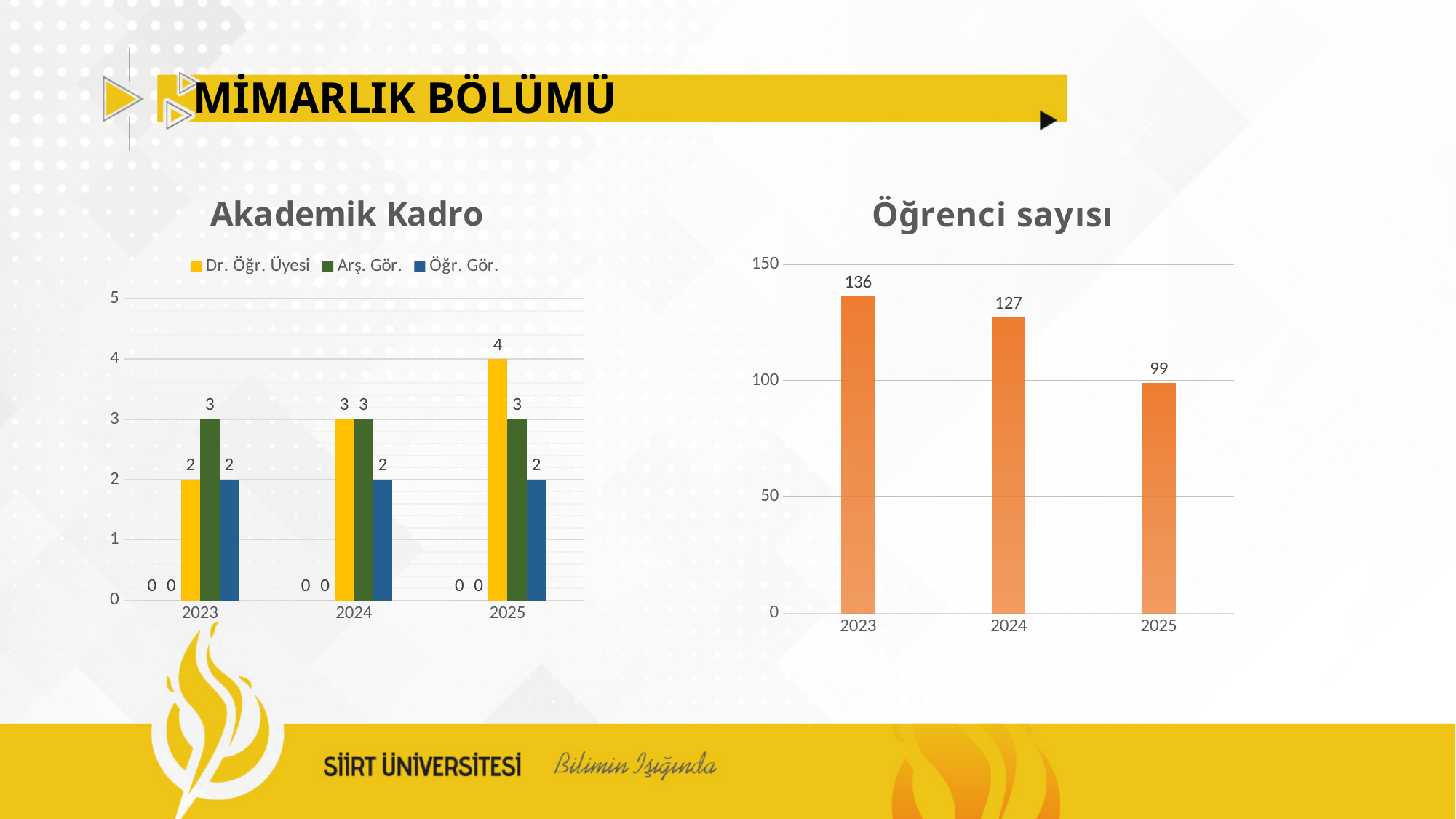
In the Öğrenci sayısı chart, what is the value for 2024? 127 In the Akademik Kadro chart, how many series does the legend list? 3 In the Akademik Kadro chart, what is the value for Öğr. Gör. in 2024? 2 In the Akademik Kadro chart, what is the value for Arş. Gör. in 2023? 3 In the Akademik Kadro chart, what is the difference between the Dr. Öğr. Üyesi value and the Öğr. Gör. value in 2025? 2 What kind of chart is the Öğrenci sayısı chart? bar chart In the Öğrenci sayısı chart, do the values rise or fall from 2023 to 2025? fall In the Akademik Kadro chart, in which year is the Dr. Öğr. Üyesi value highest? 2025 In the Öğrenci sayısı chart, what is the difference between the 2023 and 2025 values? 37 In the Öğrenci sayısı chart, which year has the lowest value? 2025 In the Akademik Kadro chart, what is the value for Dr. Öğr. Üyesi in 2025? 4 In the Öğrenci sayısı chart, how many years are shown on the x axis? 3